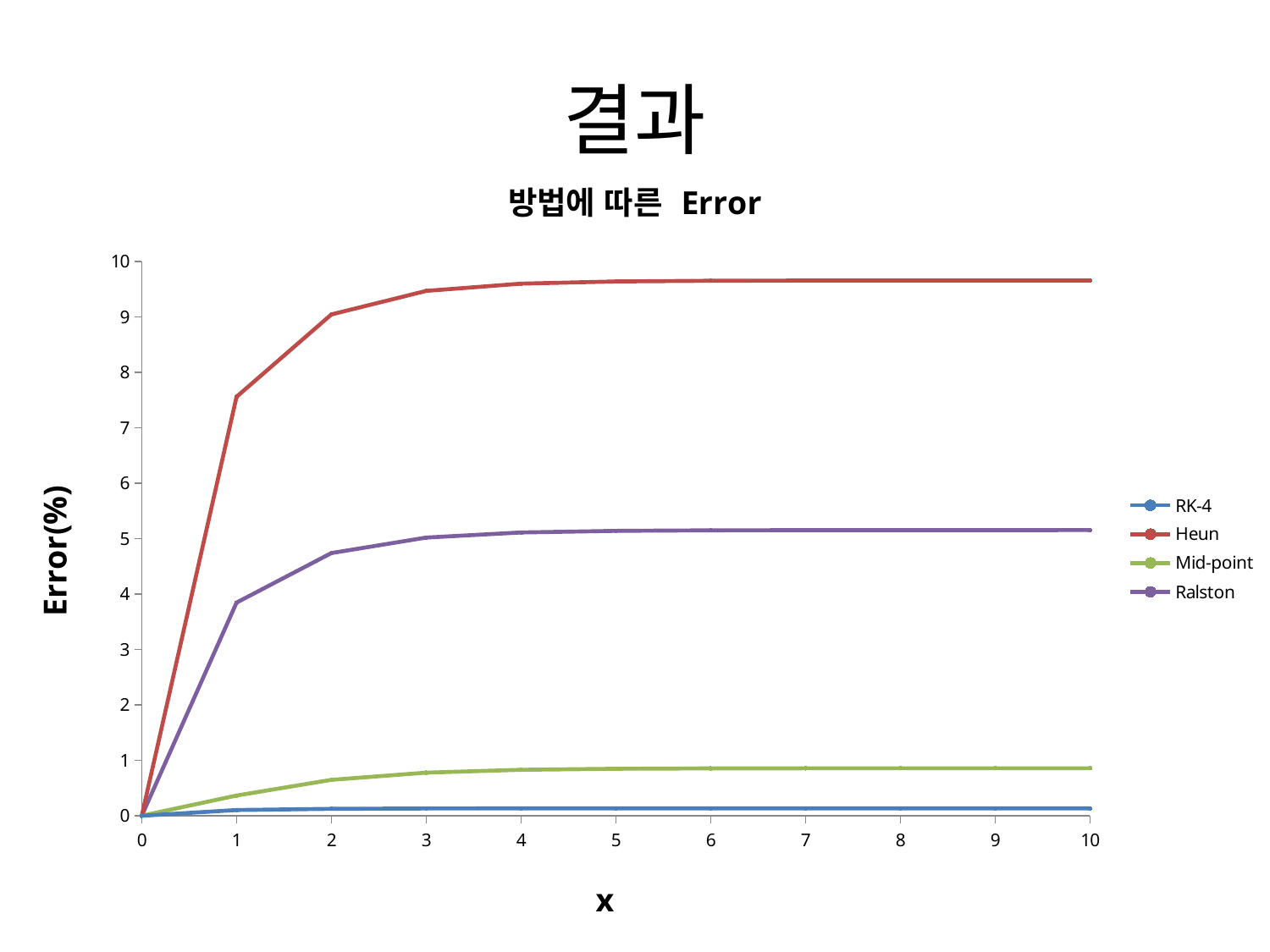
What is the label of the vertical axis? Error(%) How many x-axis tick values are shown on the chart? 11 What kind of chart is shown on the slide? line chart Does the Heun series rise or fall as x increases from 0 to 2? rise Is the value for Heun at x = 5 greater or less than 9? greater Is the value for Mid-point at x = 10 greater or less than 1? less Is the value for Heun at x = 1 greater or less than 7? greater How many series does the legend list? 4 Which is larger at x = 3, the error for Ralston or the error for Mid-point? Ralston Which series has the highest error at x = 10? Heun Which series has the lowest error at x = 10? RK-4